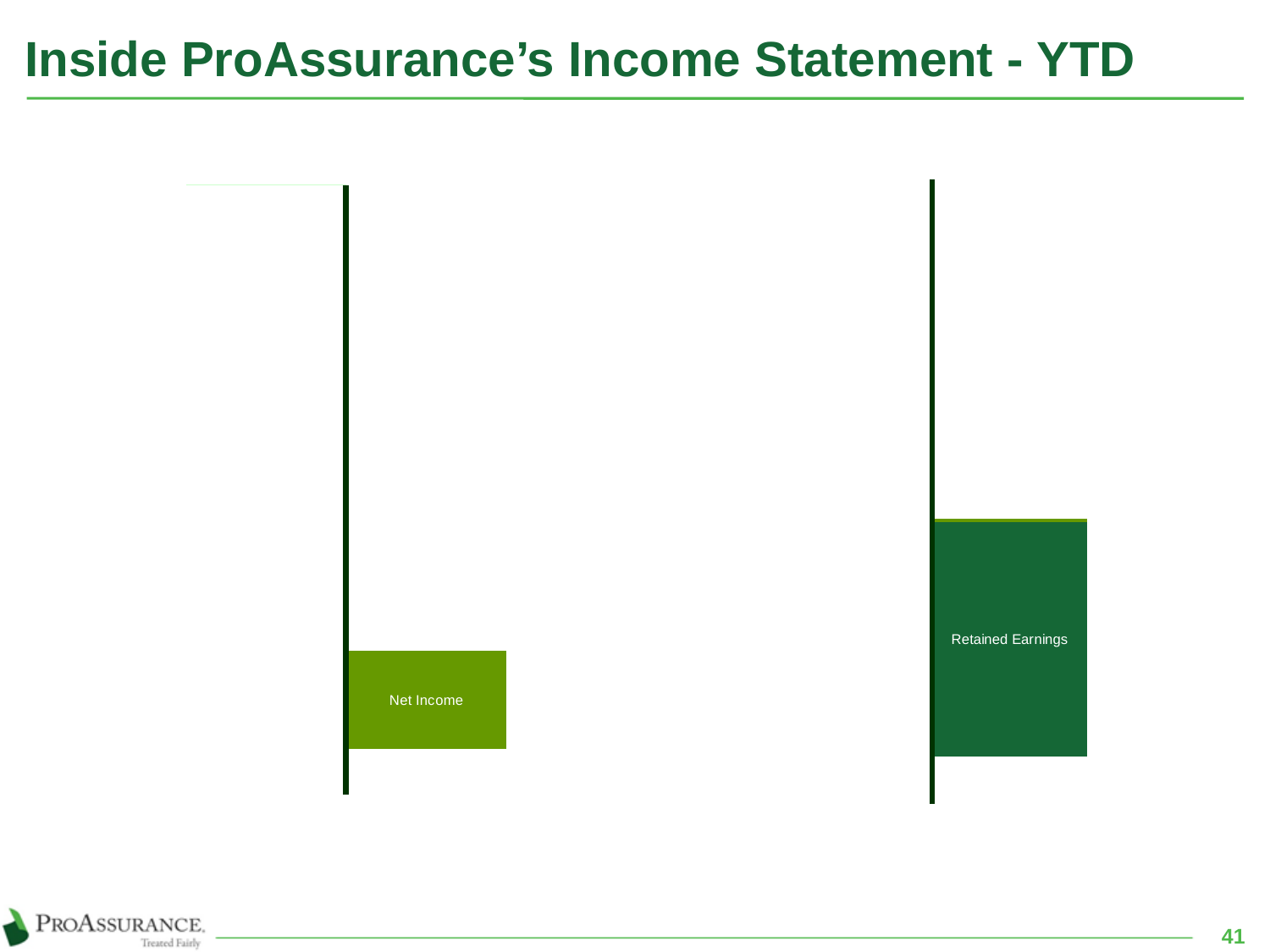
Which category has the shortest bar on the chart? Net Income Which bar is taller, Net Income or Retained Earnings? Retained Earnings Which category has the tallest bar on the chart? Retained Earnings What kind of chart is shown on the slide? Bar chart What is the label on the left-hand bar of the chart? Net Income What is the title of the slide containing the chart? Inside ProAssurance's Income Statement - YTD How many bars are plotted on the chart? 2